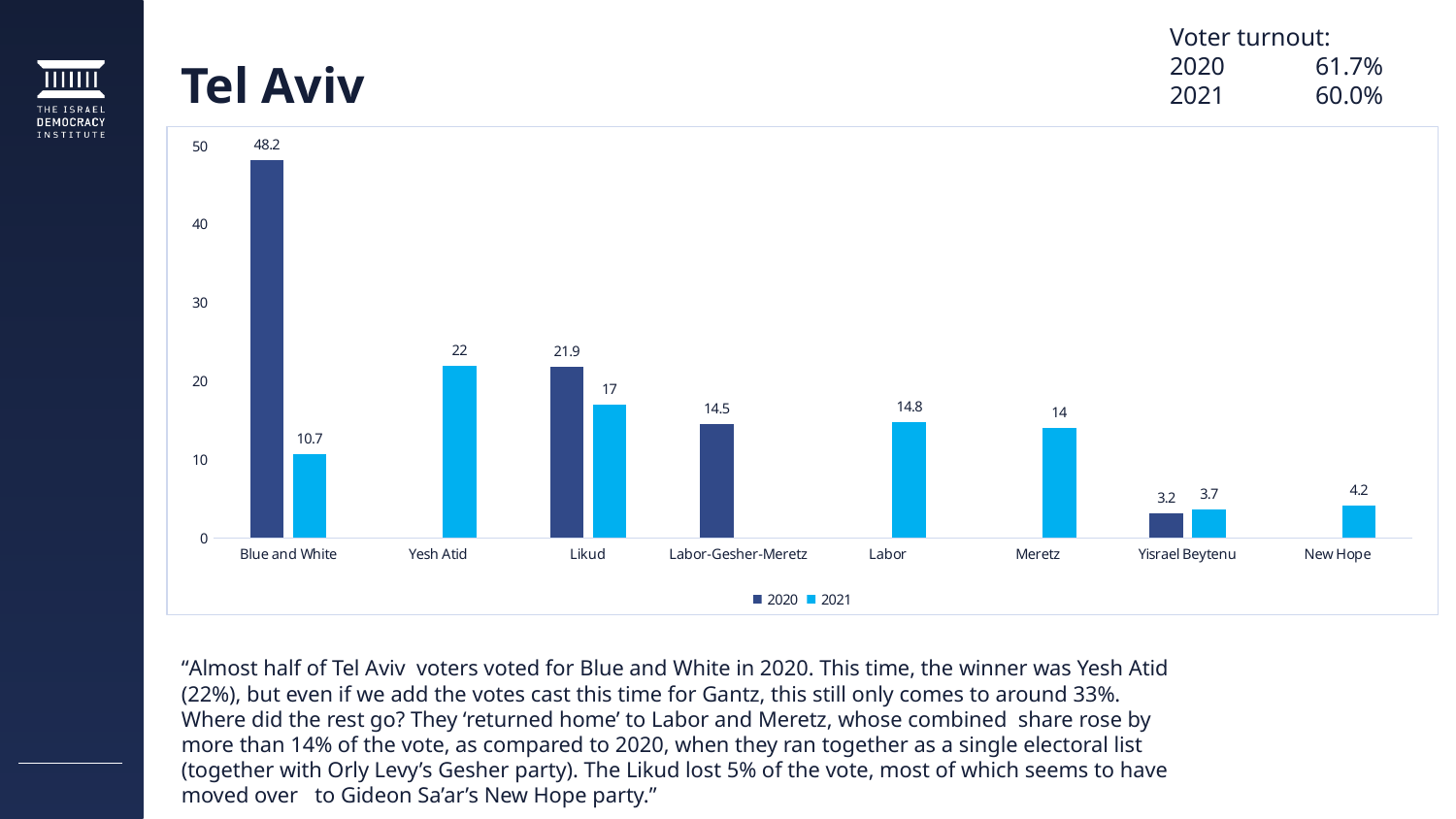
Which category has the lowest value in the 2021 series? Yisrael Beytenu Which is larger: the 2021 value for Labor or the 2021 value for Meretz? Labor What is the title of the slide? Tel Aviv How many series does the legend list? 2 What was the value for Blue and White in 2020? 48.2 What kind of chart is shown on the slide? Bar chart What was the value for Yesh Atid in 2021? 22 What was the value for Blue and White in 2021? 10.7 How many categories are shown on the x axis? 8 Which category has the highest value in the 2020 series? Blue and White What is the difference between the Likud values for 2020 and 2021? 4.9 What was the value for Likud in 2021? 17